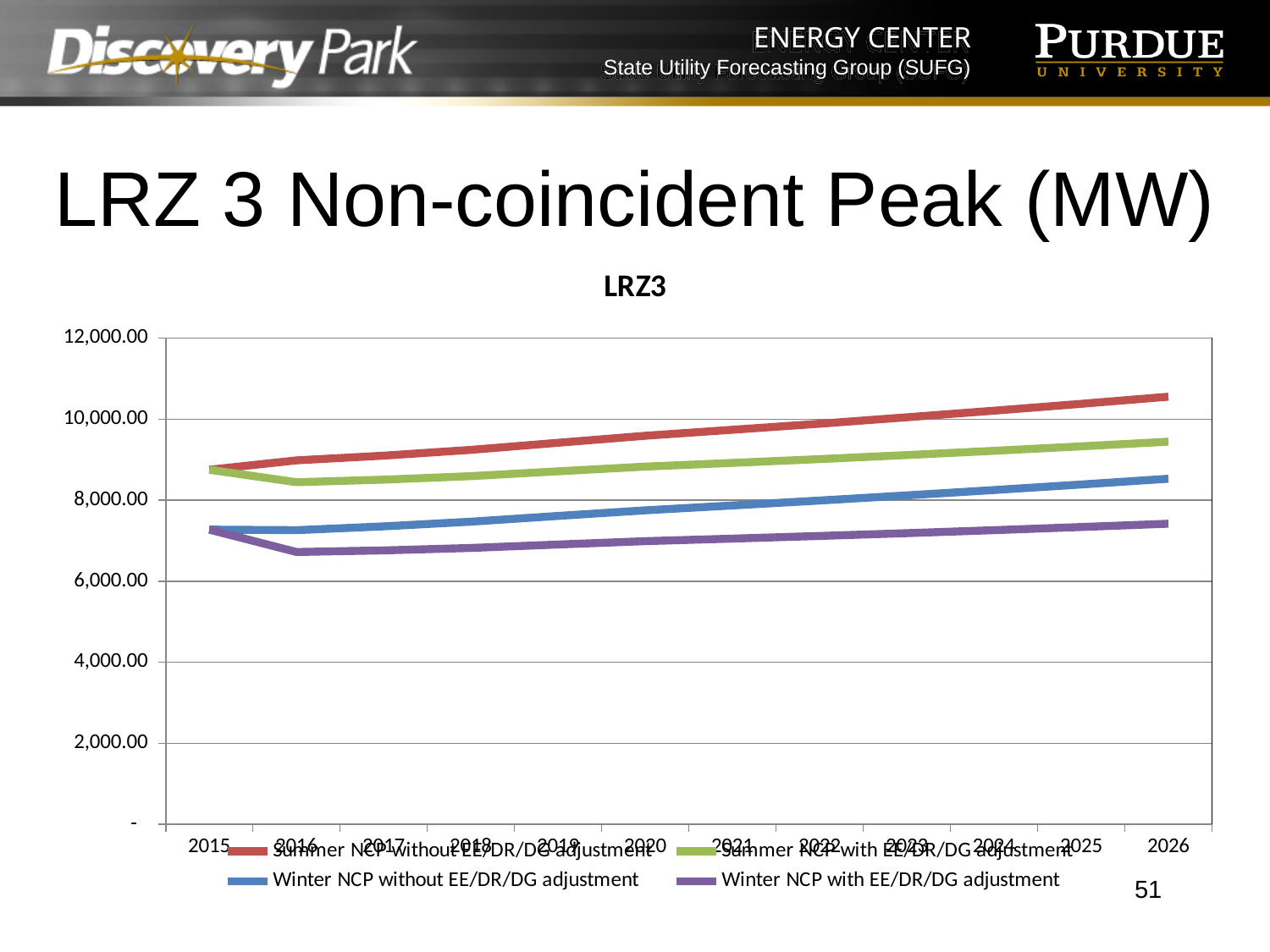
Which series has the lowest value in 2026? Winter NCP with EE/DR/DG adjustment Is the value for Summer NCP without EE/DR/DG adjustment in 2026 greater or less than 10,000.00? greater Is the value for Winter NCP without EE/DR/DG adjustment in 2026 greater or less than 8,000.00? greater What colour is the line for Winter NCP with EE/DR/DG adjustment? Purple How many series does the legend list? 4 Which series has the highest value in 2026? Summer NCP without EE/DR/DG adjustment Is the value for Winter NCP with EE/DR/DG adjustment in 2016 greater or less than 8,000.00? less What kind of chart is shown on the slide? Line chart What is the title of the chart? LRZ3 In 2026, which is larger: Summer NCP without EE/DR/DG adjustment or Summer NCP with EE/DR/DG adjustment? Summer NCP without EE/DR/DG adjustment Does the Summer NCP without EE/DR/DG adjustment line rise or fall from 2015 to 2026? Rise How many years are shown along the x axis? 12